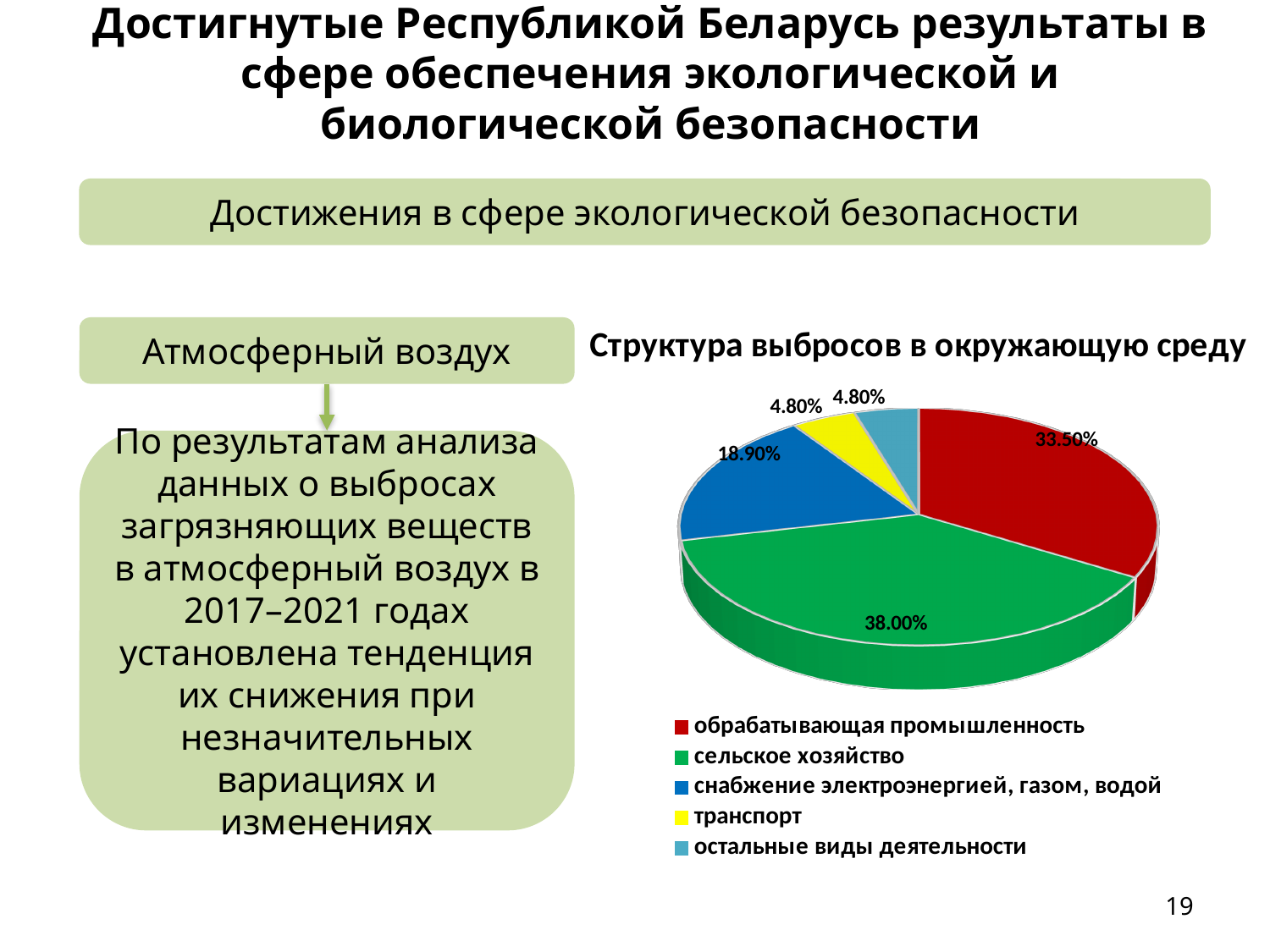
What colour represents обрабатывающая промышленность in the chart? Red Which is larger: the share of снабжение электроэнергией, газом, водой or the share of транспорт? снабжение электроэнергией, газом, водой What is the combined share of транспорт and остальные виды деятельности? 9.60% What share of emissions does сельское хозяйство account for? 38.00% How many categories does the legend list? 5 What share of emissions does обрабатывающая промышленность account for? 33.50% What is the difference between the shares of сельское хозяйство and обрабатывающая промышленность? 4.50% What type of chart is shown on the slide? Pie chart What share of emissions does снабжение электроэнергией, газом, водой account for? 18.90% Which category has the largest share of emissions? сельское хозяйство What share of emissions does транспорт account for? 4.80% What is the title of the chart? Структура выбросов в окружающую среду